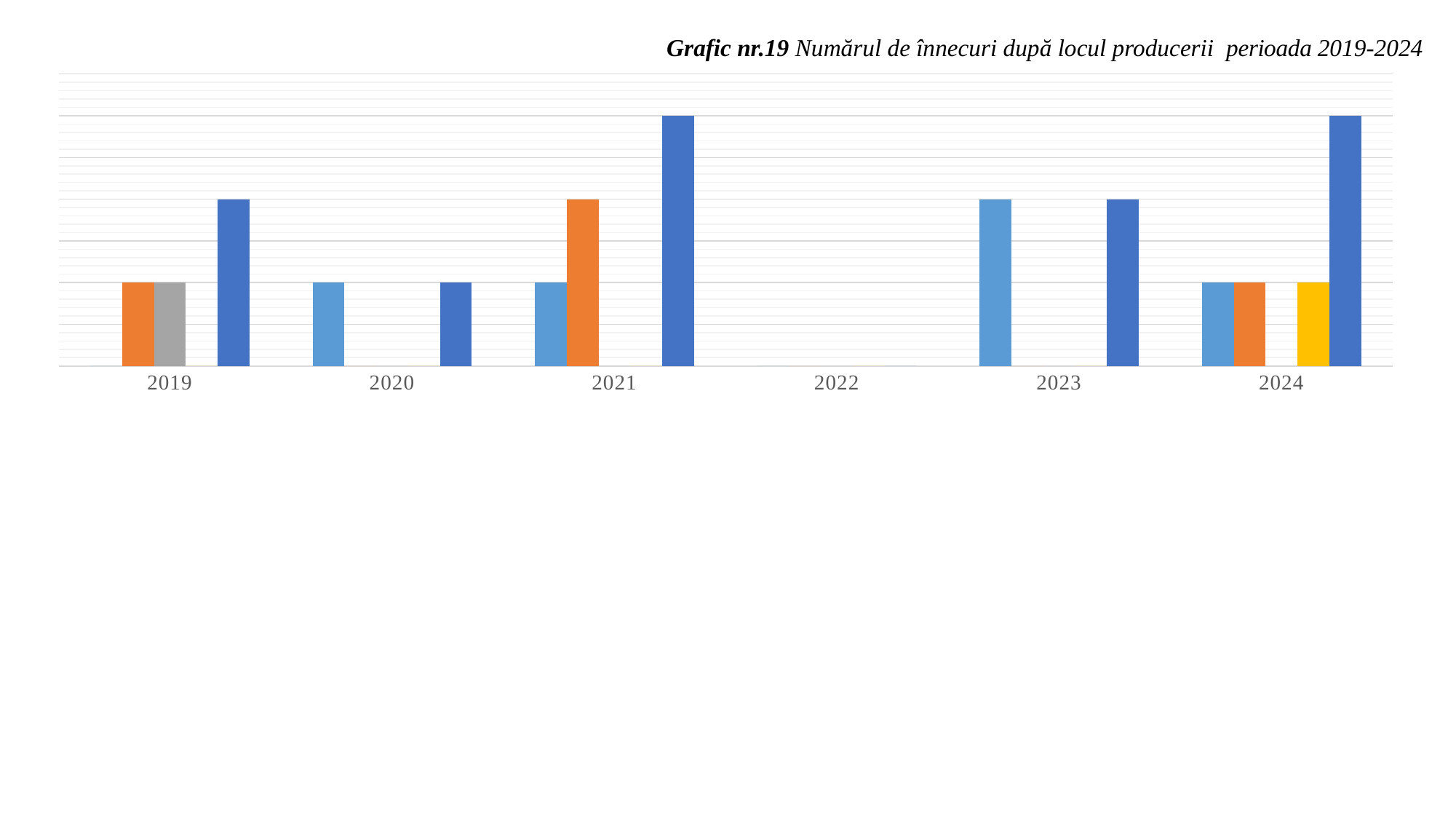
How many years are shown on the x axis of the chart? 6 Which year on the x axis has no bars plotted at all? 2022 What is the first year shown on the x axis? 2019 Which year has more bars plotted, 2020 or 2024? 2024 How many bars are plotted for the year 2019? 3 How many bars are plotted for the year 2020? 2 What is the title of the chart? Grafic nr.19 Numărul de înnecuri după locul producerii perioada 2019-2024 What kind of chart is shown on the slide? bar chart